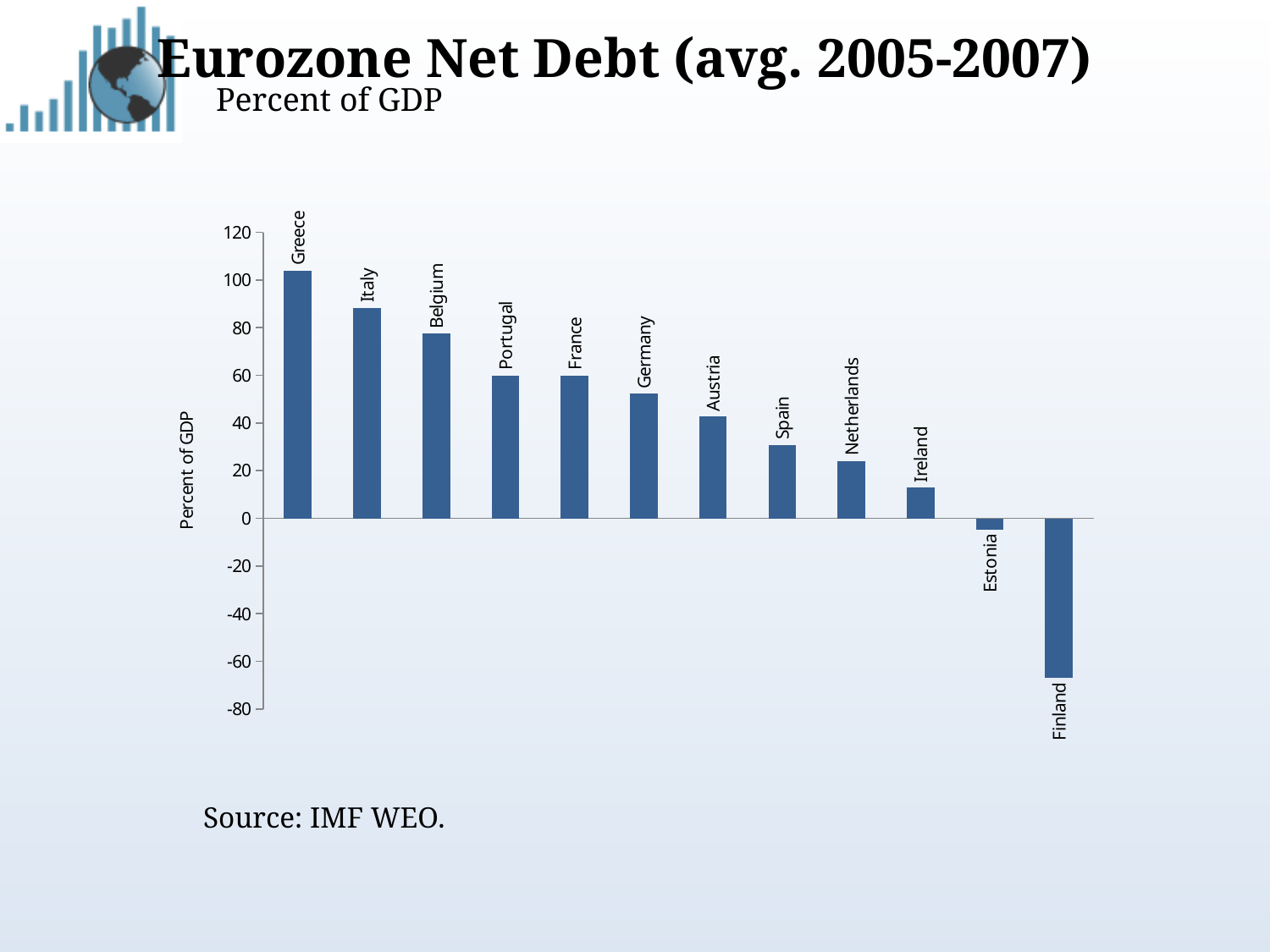
Which country has the lowest net debt as a percent of GDP? Finland Is the value for Italy greater or less than 80? greater What is the label on the vertical axis of the chart? Percent of GDP Which is larger, the value for Belgium or the value for Austria? Belgium Is the value for Greece greater or less than 100? greater What kind of chart is shown on the slide? bar chart How many countries are shown in the chart? 12 Is the value for Germany greater or less than 60? less Which country has the highest net debt as a percent of GDP? Greece Which is larger, the value for Spain or the value for Netherlands? Spain Do the values generally rise or fall moving from left to right across the chart? fall